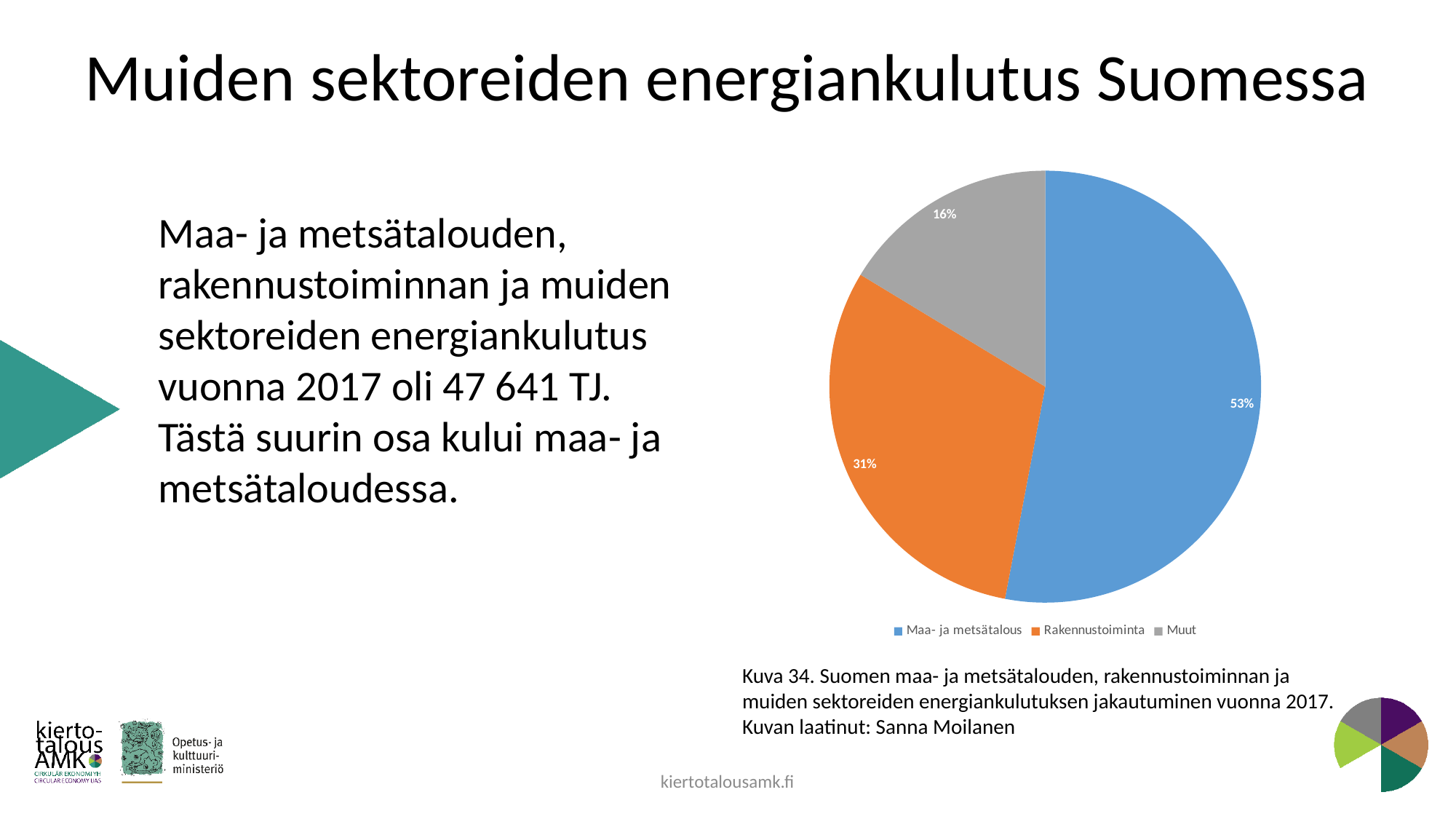
What colour is the slice for Rakennustoiminta? orange What share of the pie does Rakennustoiminta have? 31% Which is larger, the share for Rakennustoiminta or the share for Muut? Rakennustoiminta What is the difference in percentage points between Maa- ja metsätalous and Rakennustoiminta? 22 What is the difference in percentage points between Rakennustoiminta and Muut? 15 What share of the pie does Maa- ja metsätalous have? 53% What kind of chart is shown on the slide? pie chart Which category has the largest slice of the pie? Maa- ja metsätalous What share of the pie does Muut have? 16% How many categories does the pie chart have? 3 Which category is shown in grey in the legend? Muut Which category has the smallest slice of the pie? Muut